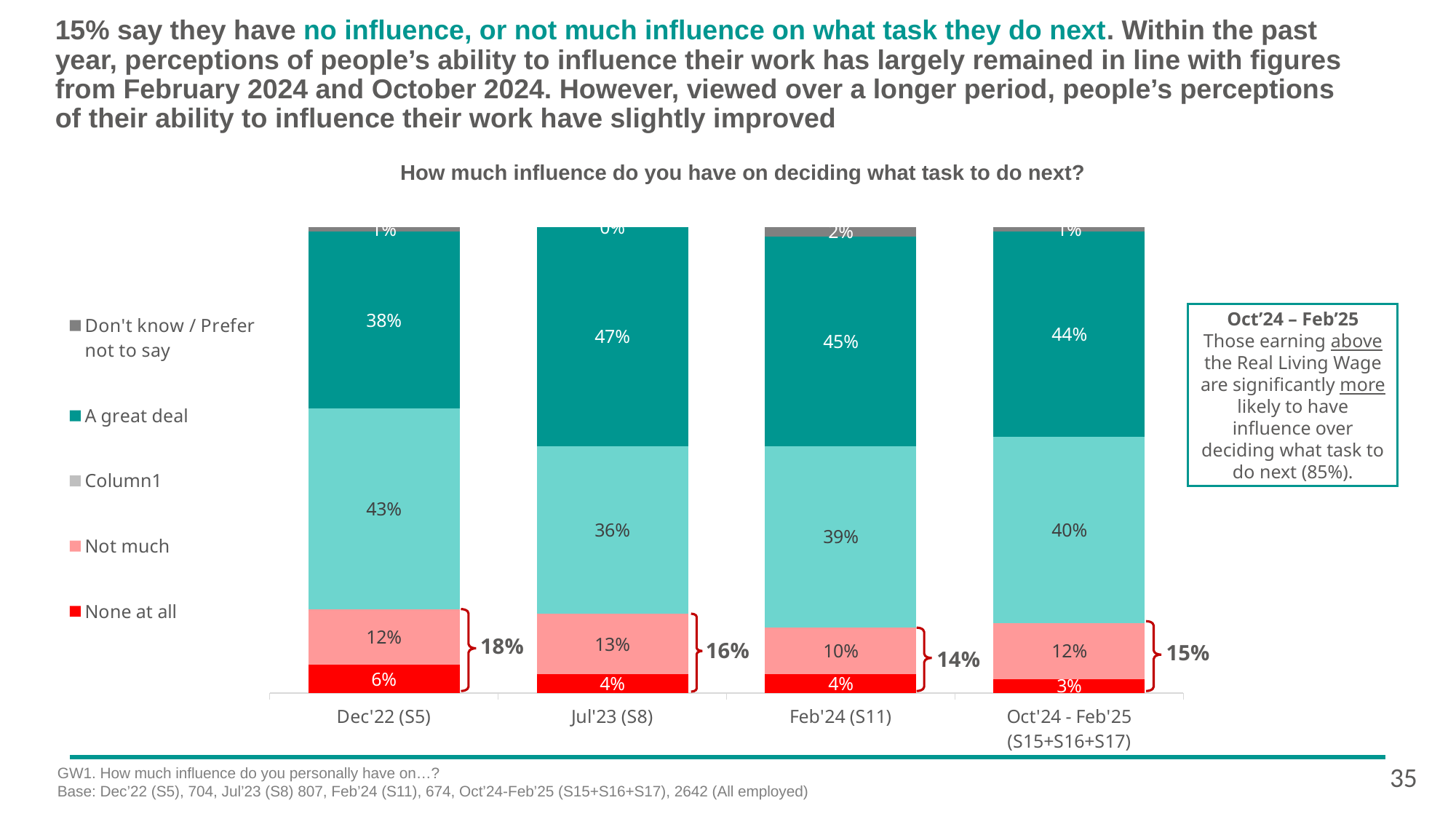
Which is larger: the 'Not much' value for Jul'23 (S8) or for Feb'24 (S11)? Jul'23 (S8) How many time periods (bars) are shown on the x axis of the chart? 4 What is the title of the chart? How much influence do you have on deciding what task to do next? Which period has the lowest 'None at all' value? Oct'24 - Feb'25 (S15+S16+S17) What is the 'A great deal' value for Jul'23 (S8)? 47% What type of chart is shown on the slide? Stacked bar chart How many series does the chart legend list? 5 What is the 'Not much' value for Feb'24 (S11)? 10% What is the difference between the 'A great deal' values for Jul'23 (S8) and Dec'22 (S5)? 9 percentage points Which period has the highest 'A great deal' value? Jul'23 (S8) What is the 'None at all' value for Dec'22 (S5)? 6% What is the combined 'None at all' and 'Not much' figure shown by the bracket for Oct'24 - Feb'25 (S15+S16+S17)? 15%